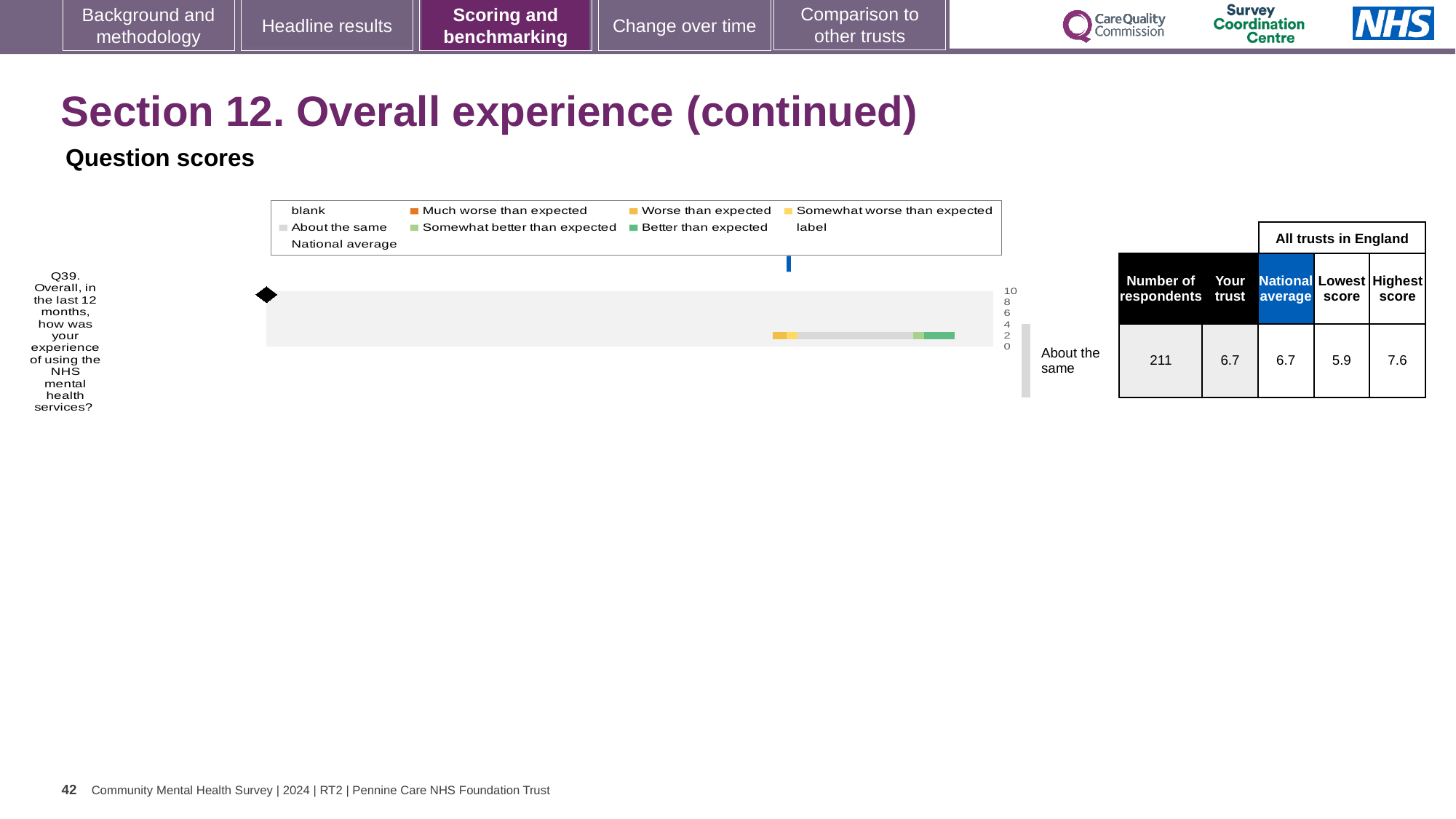
What is the national average score shown for Q39? 6.7 How many respondents answered Q39? 211 What is the lowest score among all trusts in England for Q39? 5.9 How many questions are plotted on the chart? 1 What is the difference between the trust's score and the lowest score for Q39? 0.8 What is the 'Your trust' score for Q39 (Overall, in the last 12 months, how was your experience of using the NHS mental health services?)? 6.7 What benchmarking category is the trust's Q39 result labelled as? About the same What kind of chart is used to show the question score? bar chart What is the highest score among all trusts in England for Q39? 7.6 Is the trust's score for Q39 greater or less than 4 on the chart's axis? greater Is the trust's score for Q39 higher or lower than the highest score among all trusts? lower What is the difference between the highest score and the lowest score for Q39? 1.7